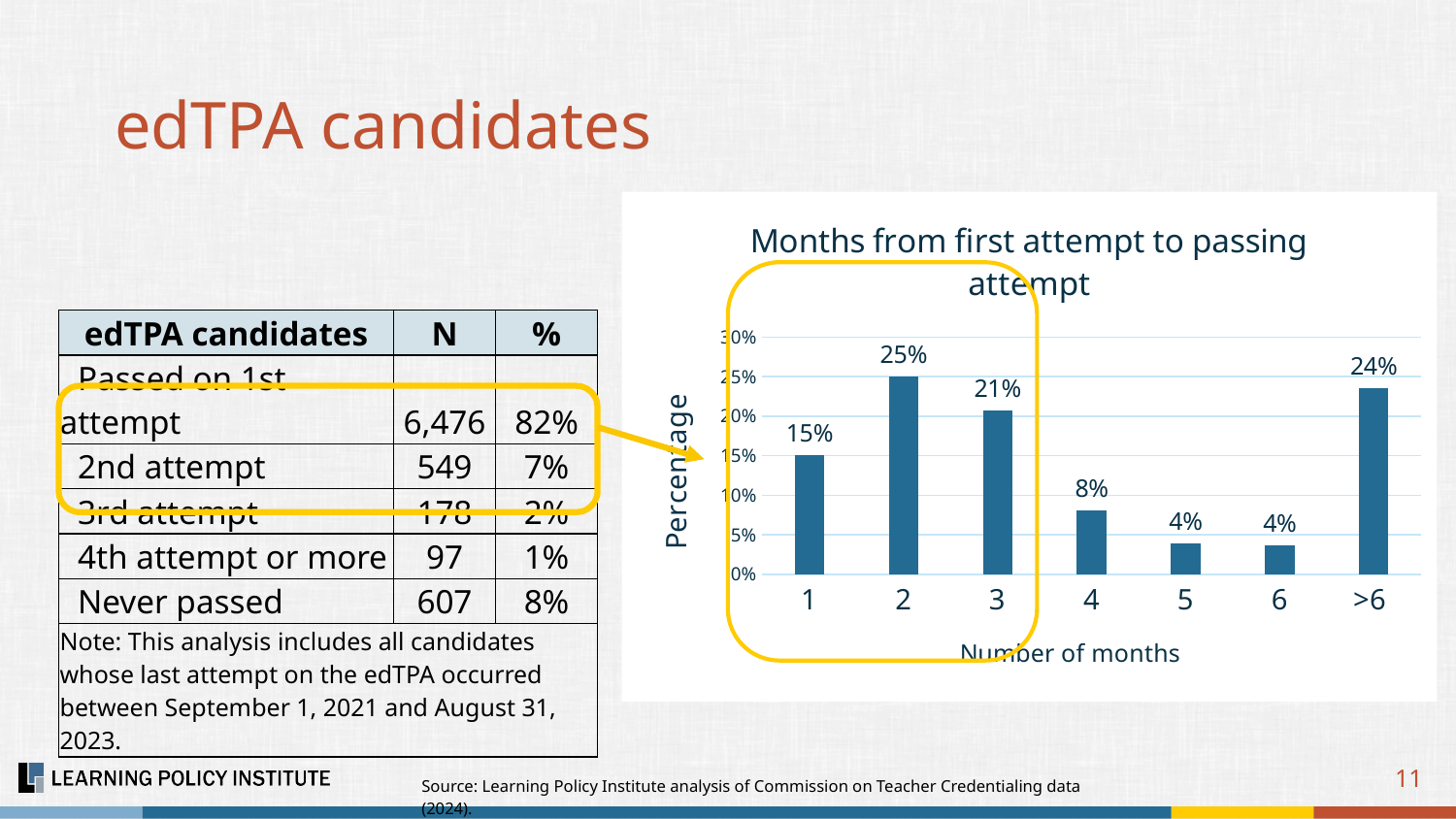
What is the difference between the percentage for 2 months and the percentage for 3 months? 4% What is the value for 1 month from first attempt to passing attempt? 15% What is the difference between the value for 1 month and the value for 4 months? 7% What percentage is shown for the '>6' months category? 24% Which is larger, the value for 1 month or the value for 3 months? 3 months What is the value shown for 4 months in the chart? 8% How many categories are shown on the x axis of the chart? 7 What is the title of the chart on the slide? Months from first attempt to passing attempt Is the value for 4 months greater or less than 10%? less Which number of months has the highest percentage in the chart? 2 What percentage of candidates passed 2 months after their first attempt? 25% What type of chart is used to show months from first attempt to passing attempt? bar chart